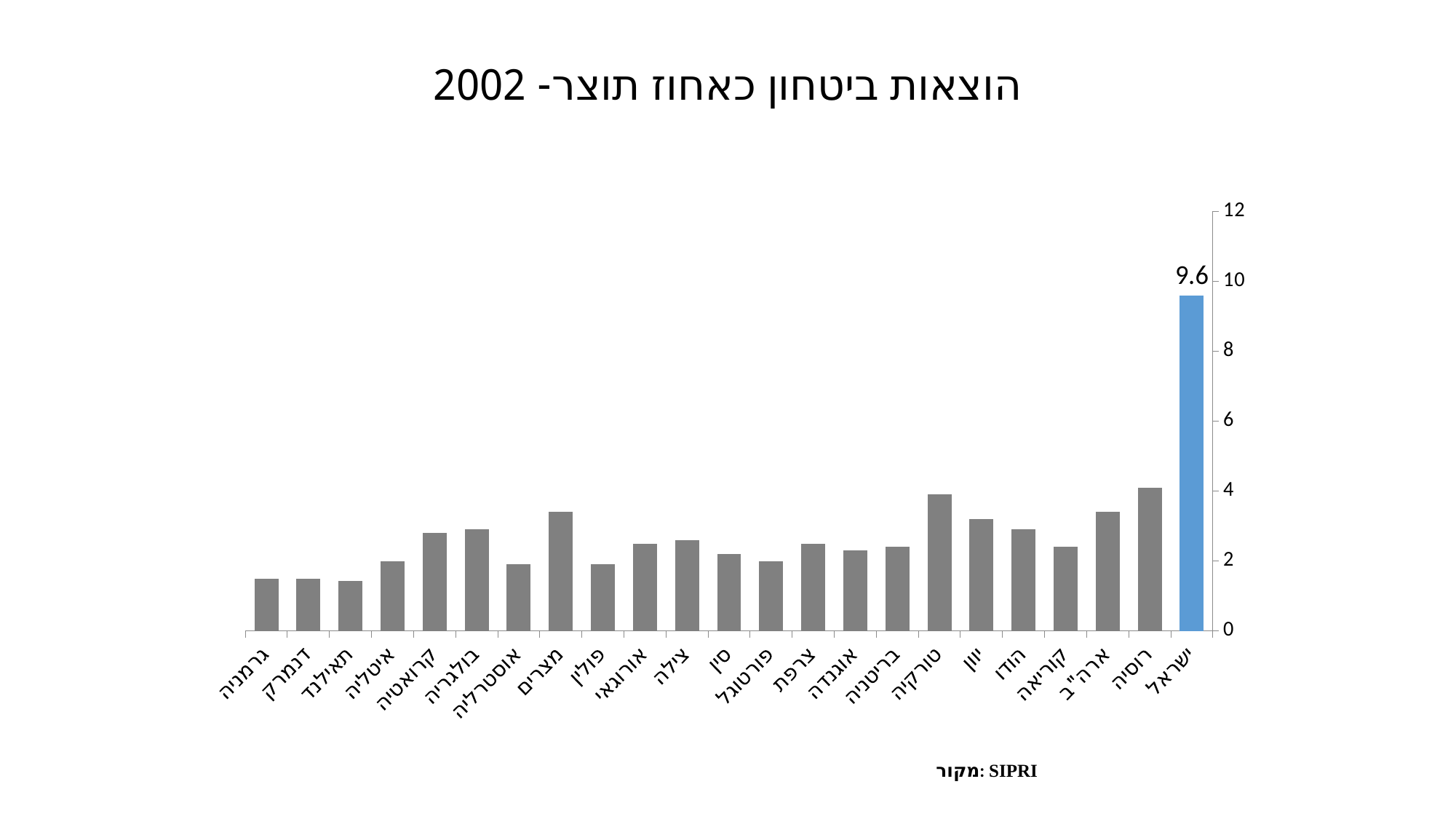
Which country has the highest value in the chart? ישראל Is the value for מצרים greater or less than 2? greater Is the value for ישראל greater or less than 8? greater What is the title of the chart? הוצאות ביטחון כאחוז תוצר- 2002 Is the value for טורקיה greater or less than 2? greater Which country's bar is coloured blue rather than grey? ישראל How many countries are shown in the chart? 23 What kind of chart is shown on the slide? bar chart What is the value shown for ישראל? 9.6 Which is larger, the value for ישראל or the value for רוסיה? ישראל Which is larger, the value for טורקיה or the value for דנמרק? טורקיה